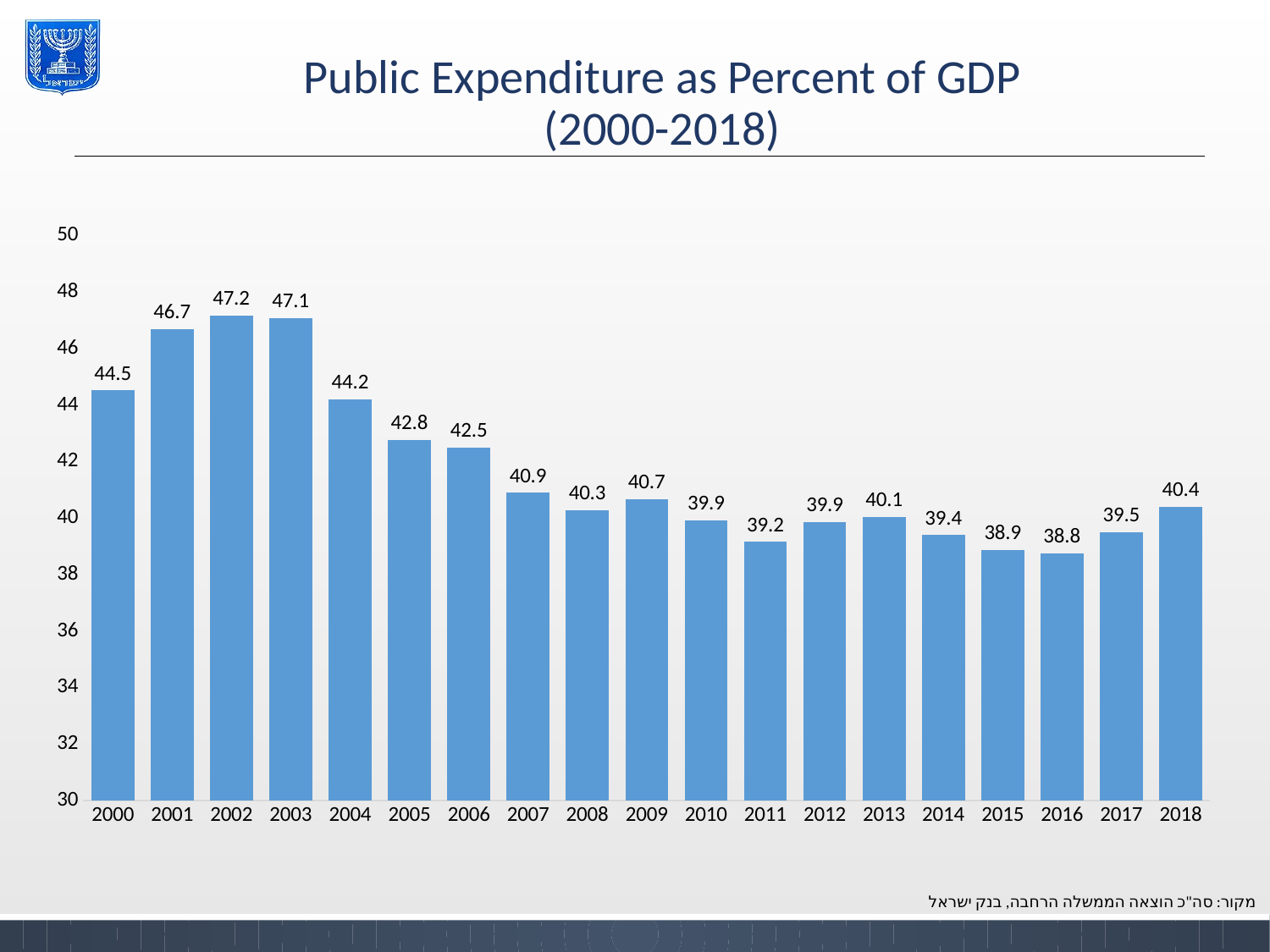
What is the value for 2016? 38.8 What is the difference between the values for 2002 and 2016? 8.4 What kind of chart is shown? bar chart Which year has the highest value? 2002 What is the value for 2018? 40.4 Which year has the lowest value? 2016 What is the title of the chart? Public Expenditure as Percent of GDP (2000-2018) Do the values generally rise or fall from 2003 to 2016? fall Is the value for 2011 greater or less than 40? less What is the value for 2002? 47.2 Which is larger, the value for 2000 or the value for 2004? 2000 How many years are shown on the x axis? 19